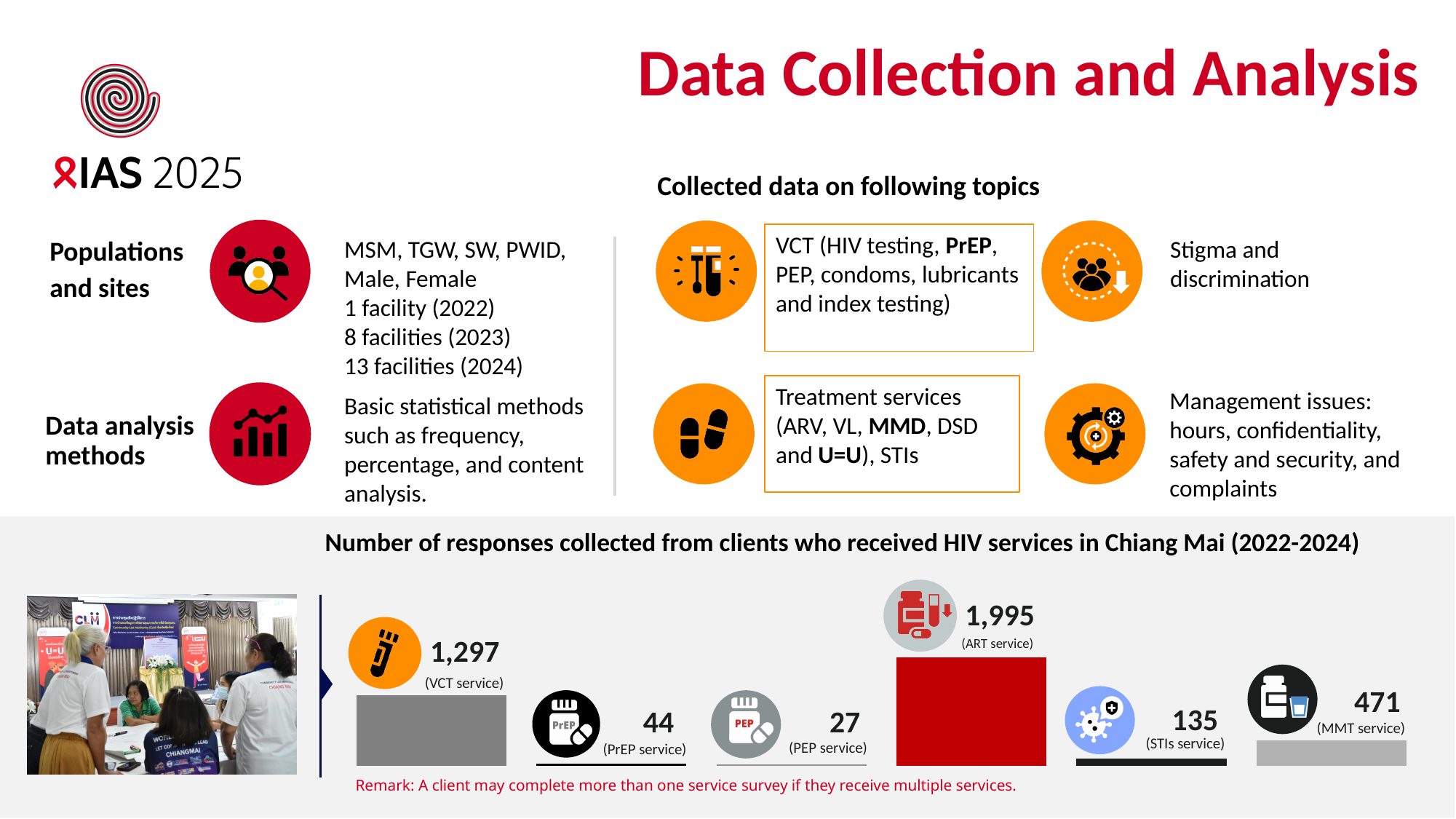
What is the number of responses for the VCT service? 1,297 Which service has the highest number of responses? ART service Which has more responses, the MMT service or the STIs service? MMT service Which service has the lowest number of responses? PEP service What is the difference between the number of responses for the STIs service and the PrEP service? 91 What is the difference between the number of responses for the ART service and the VCT service? 698 What is the number of responses for the MMT service? 471 How many services are shown in the chart of responses collected? 6 What is the number of responses for the PrEP service? 44 What kind of chart is used to show the number of responses collected? Bar chart What is the title of the chart at the bottom of the slide? Number of responses collected from clients who received HIV services in Chiang Mai (2022-2024) What is the number of responses for the ART service? 1,995